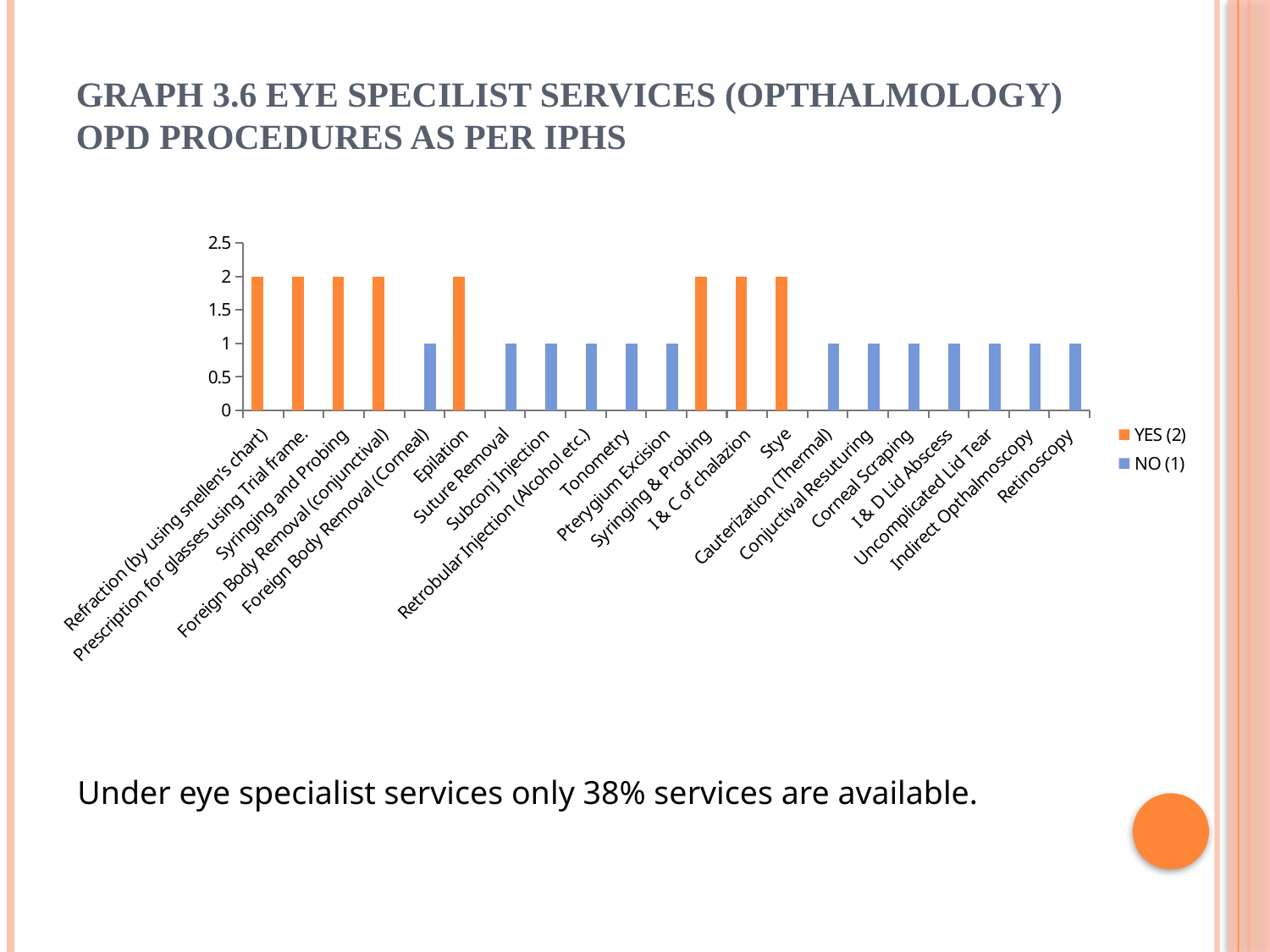
How many categories are plotted in the YES (2) series? 8 Is the value for Corneal Scraping greater or less than 1.5? less How many categories are shown on the x axis? 21 How many series does the legend list? 2 What is the value for Stye? 2 What is the difference between the value for Epilation and the value for Suture Removal? 1 What are the two legend entries? YES (2) and NO (1) What is the value for Tonometry? 1 What is the value for Retinoscopy? 1 What kind of chart is shown on the slide? bar chart Which is larger, the value for Suture Removal or the value for Stye? Stye What is the value for Epilation? 2